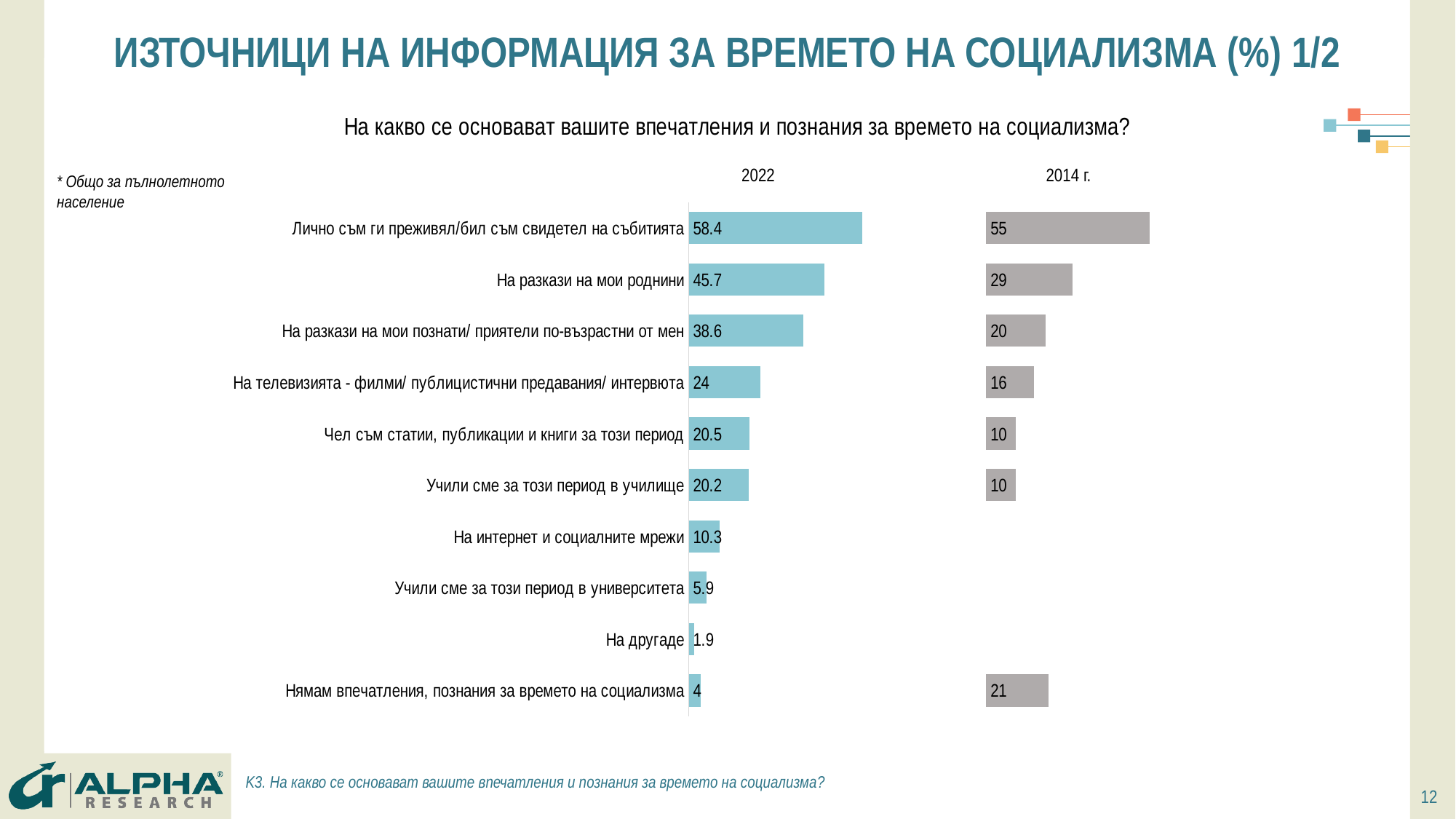
In the 2014 г. chart, which category has the highest value? Лично съм ги преживял/бил съм свидетел на събитията How many categories are listed in the 2022 chart? 10 In the 2014 г. chart, what is the value for "Нямам впечатления, познания за времето на социализма"? 21 In the 2022 chart, which category has the highest value? Лично съм ги преживял/бил съм свидетел на събитията In the 2022 chart, what is the value for "На интернет и социалните мрежи"? 10.3 What is the difference between the 2022 values for "Чел съм статии, публикации и книги за този период" and "Учили сме за този период в училище"? 0.3 In the 2014 г. chart, what is the value for "На разкази на мои роднини"? 29 For "Нямам впечатления, познания за времето на социализма", is the value larger in the 2022 chart or the 2014 г. chart? 2014 г. In the 2022 chart, which category has the lowest value? На другаде What is the difference between the 2022 and 2014 г. values for "На разкази на мои роднини"? 16.7 What type of chart is used on this slide? Bar chart In the 2022 chart, what is the value for "Лично съм ги преживял/бил съм свидетел на събитията"? 58.4